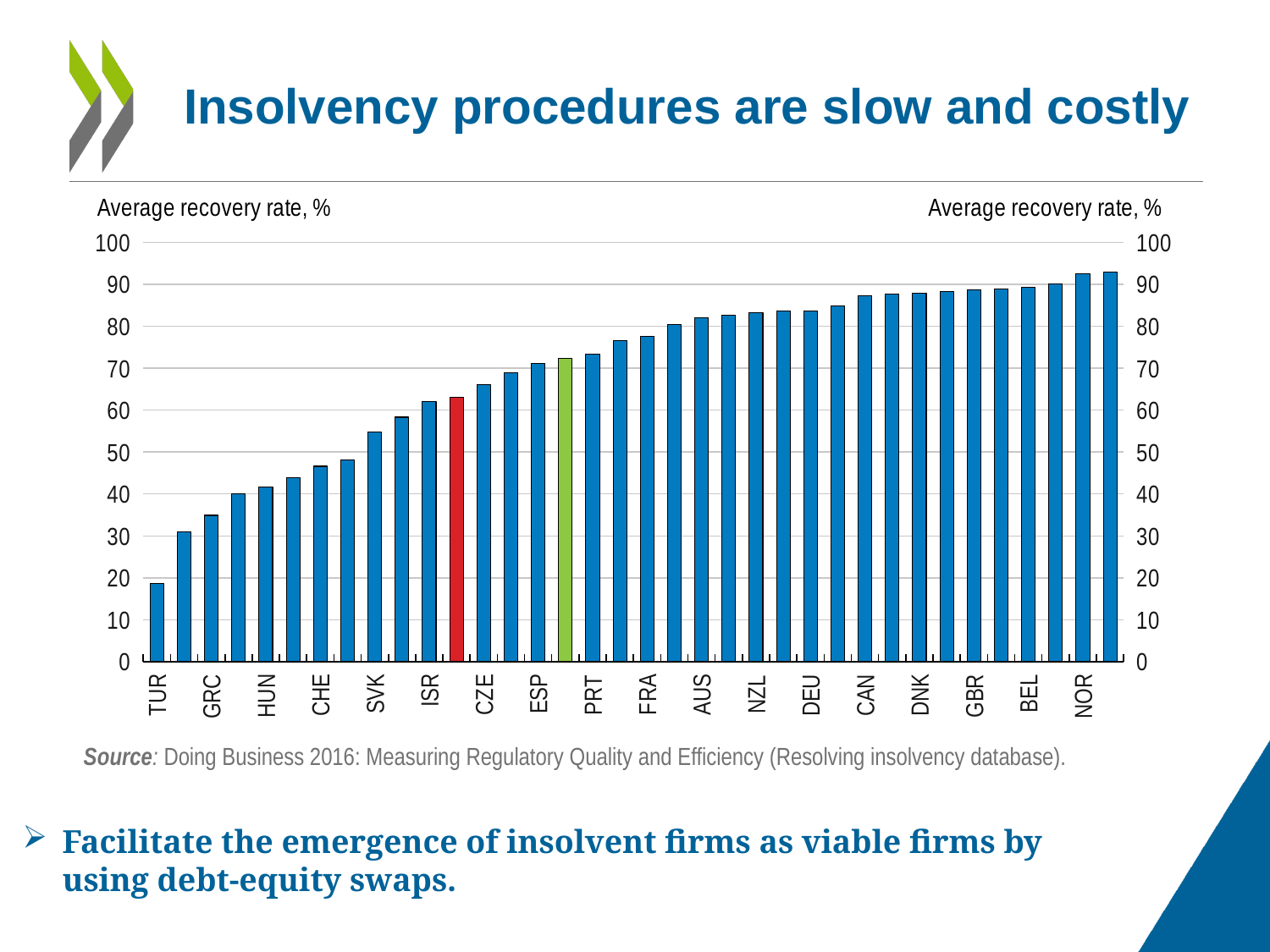
Do the bars rise or fall moving from left to right along the x axis? rise What is the title of the vertical axis? Average recovery rate, % Is the value for SVK greater or less than 50? greater Which has the larger average recovery rate, HUN or AUS? AUS Which has the larger average recovery rate, GRC or FRA? FRA Is the value for NOR greater or less than 90? greater Which labelled country has the lowest average recovery rate? TUR Is the value for GRC greater or less than 30? greater What kind of chart is shown on the slide? bar chart